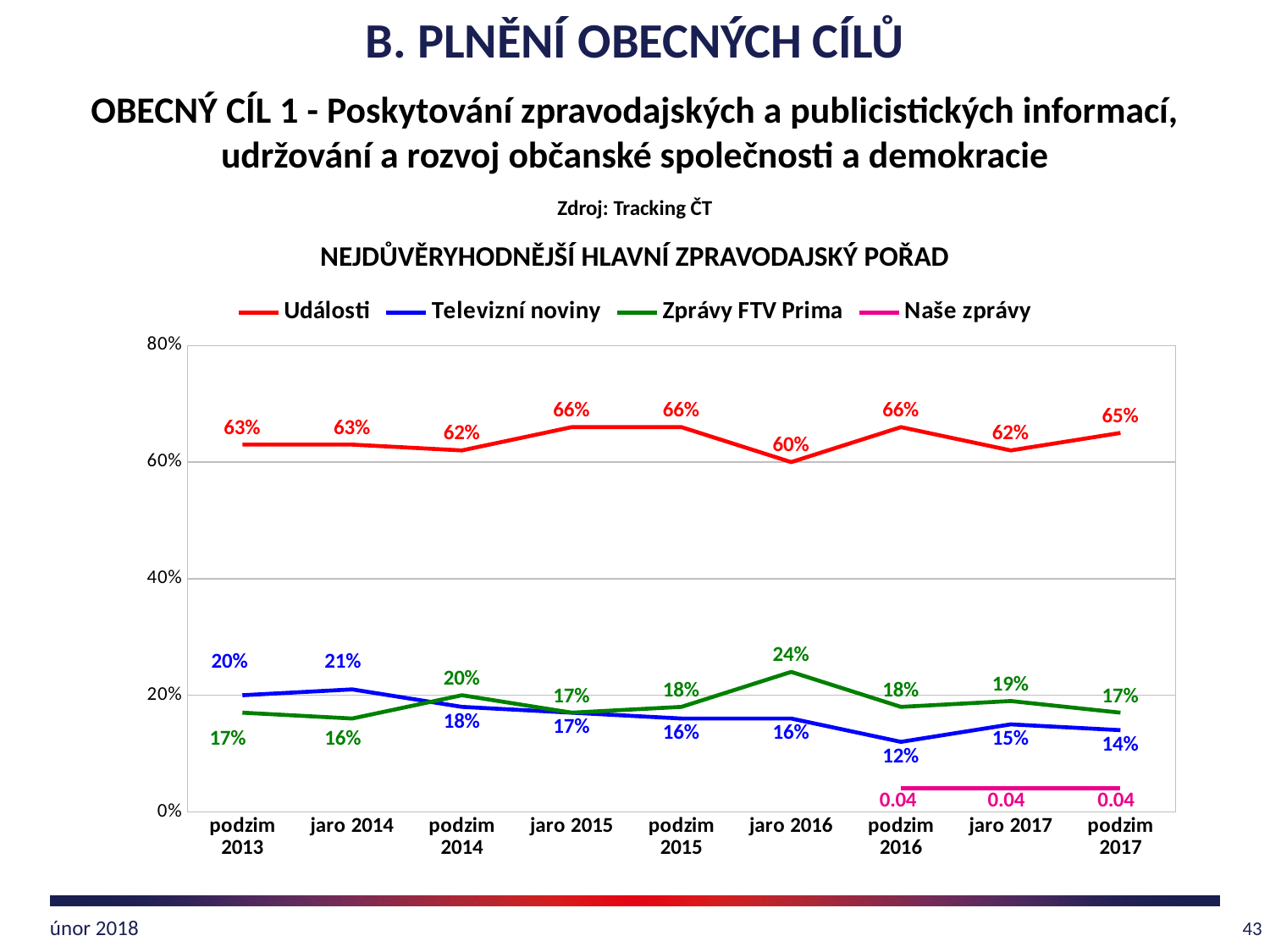
How many series does the legend list? 4 Does the Televizní noviny series generally rise or fall from podzim 2013 to podzim 2017? fall What is the value for Zprávy FTV Prima in jaro 2016? 24% In which period does Události reach its lowest value? jaro 2016 What is the title of the chart? NEJDŮVĚRYHODNĚJŠÍ HLAVNÍ ZPRAVODAJSKÝ POŘAD What is the value for Události in jaro 2016? 60% What type of chart is shown on the slide? line chart What is the value for Televizní noviny in podzim 2016? 12% Which is larger in podzim 2014: Televizní noviny or Zprávy FTV Prima? Zprávy FTV Prima In which period does Zprávy FTV Prima reach its highest value? jaro 2016 What is the difference between Události and Televizní noviny in podzim 2017? 51% How many time periods are shown on the x axis? 9